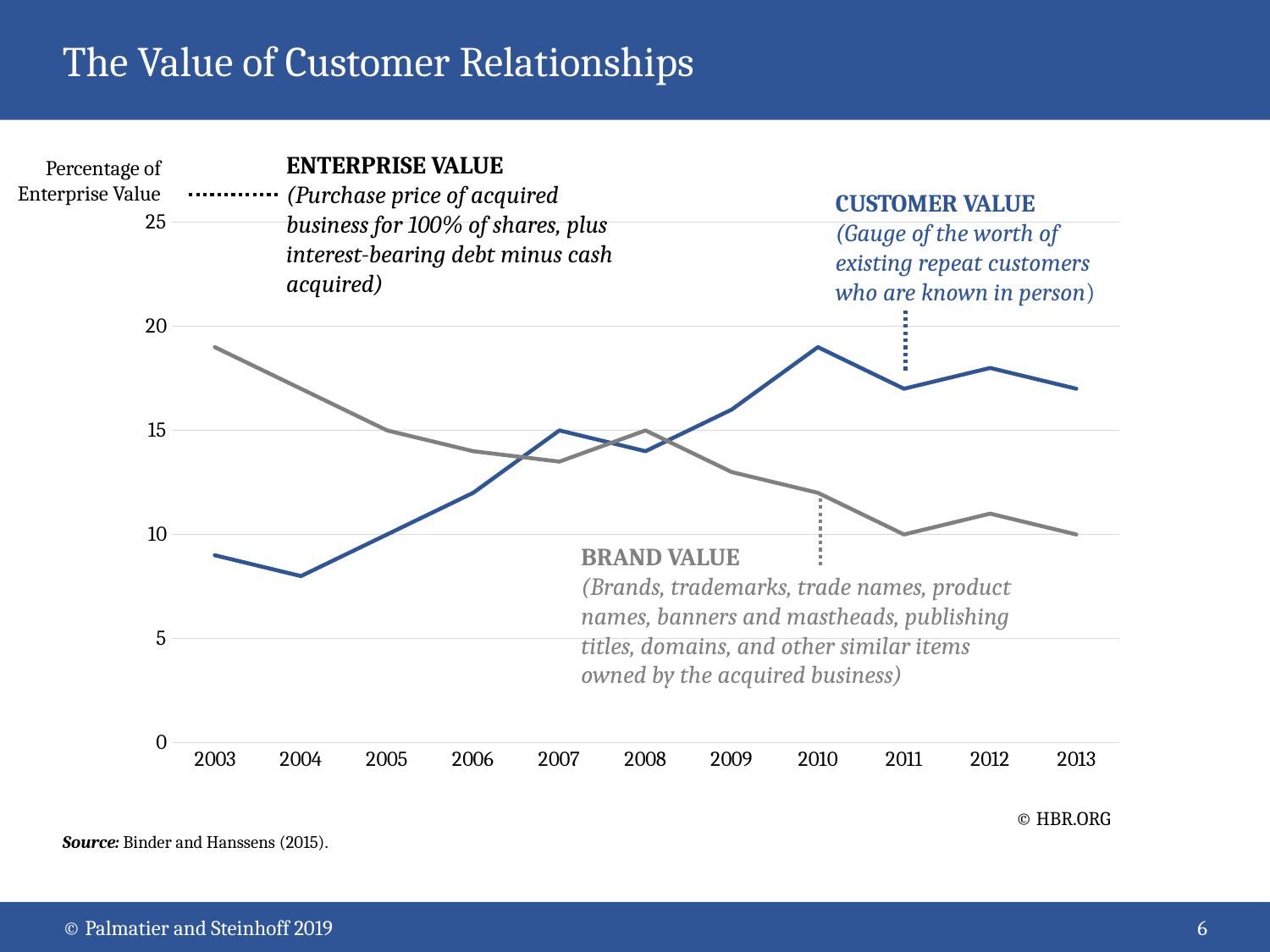
How many years are shown on the x axis of the chart? 11 Is the Customer Value in 2003 greater or less than 10? less Does Brand Value generally rise or fall from 2003 to 2013? Fall In 2013, which is larger: Brand Value or Customer Value? Customer Value In 2003, which is larger: Brand Value or Customer Value? Brand Value In which year is Customer Value at its lowest? 2004 Is the Customer Value in 2013 greater or less than 15? greater In which year is Brand Value at its highest? 2003 Is the Brand Value in 2003 greater or less than 15? greater In which year does Customer Value reach its highest percentage of enterprise value? 2010 What kind of chart is shown on the slide? Line chart How many series are plotted on the chart? 2